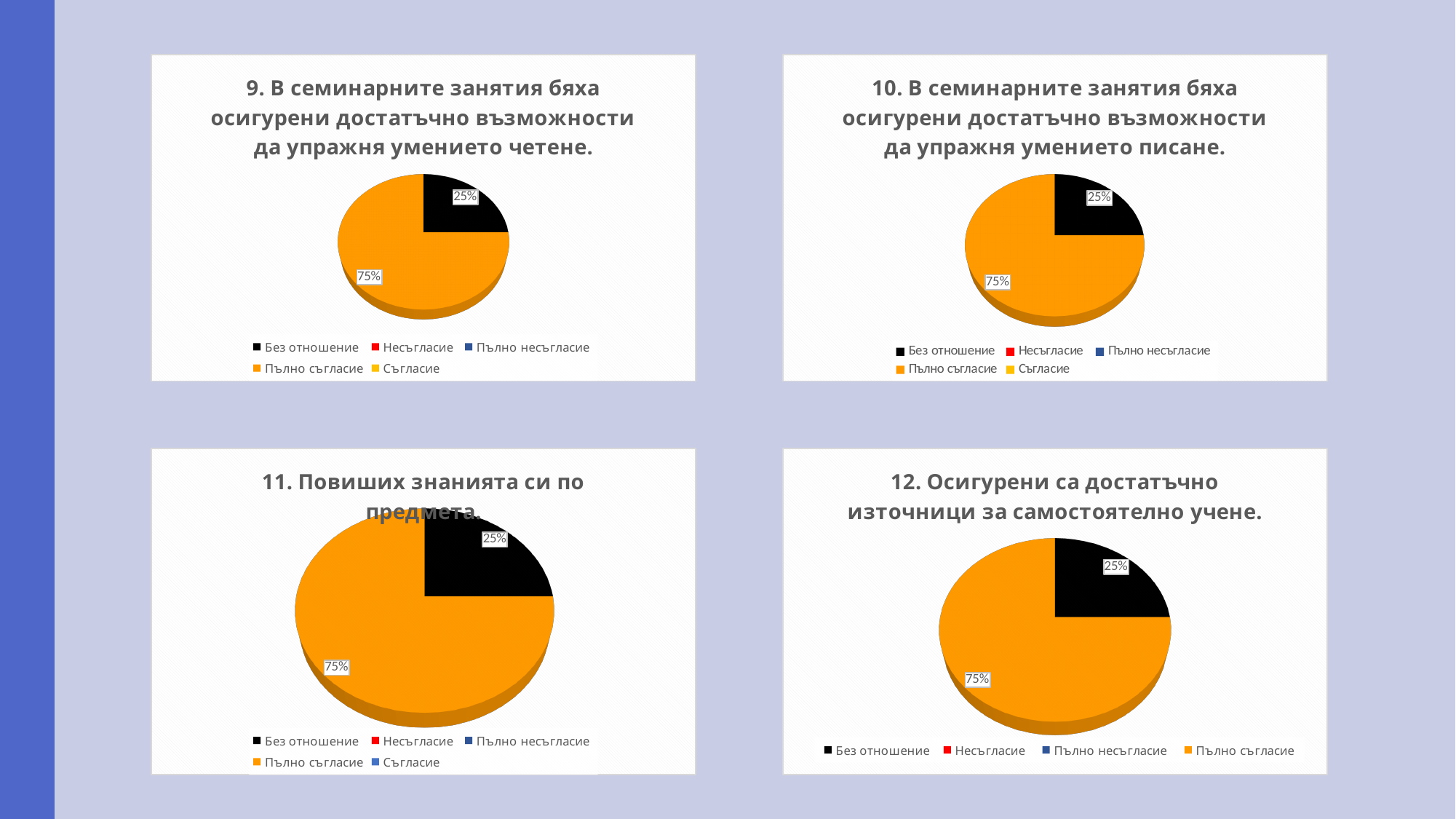
In the bottom-right chart (question 12), what colour is the "Без отношение" slice? Black In the top-right chart (question 10), what is the difference between the "Пълно съгласие" slice and the "Без отношение" slice? 50% In the bottom-left chart (question 11), what share of the pie is labelled "Без отношение"? 25% In the bottom-right chart (question 12), which category has the smallest visible slice? Без отношение What type of chart is the top-left chart (question 9)? Pie chart How many entries does the legend of the bottom-right chart (question 12) list? 4 In the top-left chart (question 9), what share of the pie is labelled "Пълно съгласие"? 75% In the top-right chart (question 10), which category has the largest slice? Пълно съгласие In the top-left chart (question 9), what share of the pie is labelled "Без отношение"? 25% How many entries does the legend of the top-left chart (question 9) list? 5 In the bottom-left chart (question 11), which is larger: the "Без отношение" slice or the "Пълно съгласие" slice? Пълно съгласие